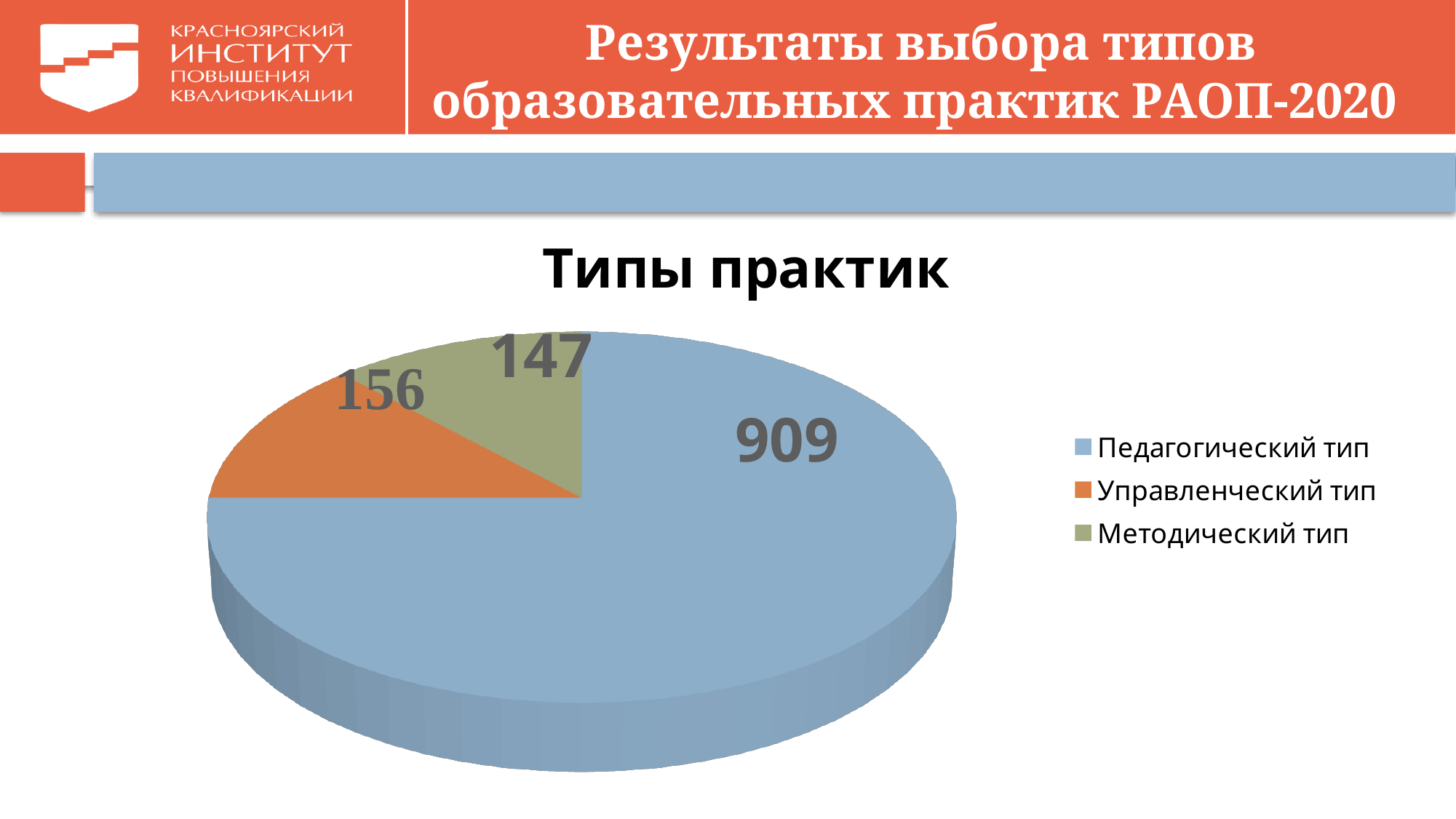
What share of the pie does Педагогический тип represent? 75% What is the value for Управленческий тип? 156 What is the value for Педагогический тип? 909 What type of chart is shown on the slide? Pie chart Which category has the lowest value? Методический тип Which category has the highest value? Педагогический тип How many categories does the pie chart have? 3 What is the difference between the values for Управленческий тип and Методический тип? 9 What is the title of the chart? Типы практик What is the difference between the values for Педагогический тип and Управленческий тип? 753 Which is larger, the value for Управленческий тип or Методический тип? Управленческий тип What is the value for Методический тип? 147